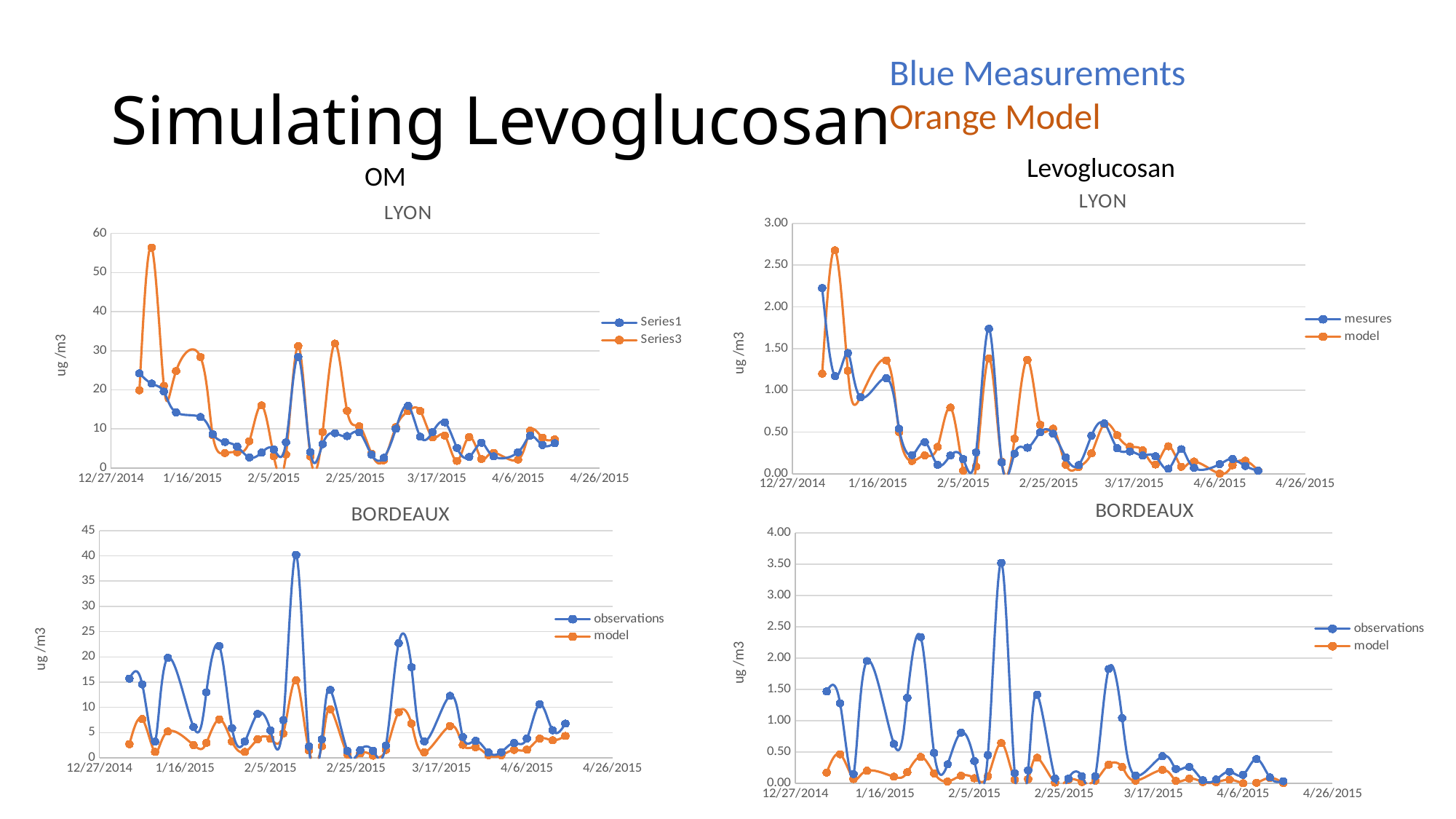
What kind of chart is the OM LYON chart at the top left of the slide? line chart What is the y-axis label on the OM BORDEAUX chart (bottom left)? ug /m3 In the OM LYON chart (top left), which series has the higher peak, Series1 or Series3? Series3 How many series does the legend of the Levoglucosan LYON chart (top right) list? 2 In the OM BORDEAUX chart (bottom left), is the peak value of the observations series greater or less than 35? greater What are the two legend entries of the Levoglucosan LYON chart (top right)? mesures, model In the Levoglucosan LYON chart (top right), do the mesures values generally rise or fall from January to April 2015? fall In the Levoglucosan BORDEAUX chart (bottom right), is the highest observations value greater or less than 3.00? greater In the OM LYON chart (top left), is the highest value of Series3 greater or less than 50? greater In the Levoglucosan BORDEAUX chart (bottom right), which series reaches the higher peak, observations or model? observations